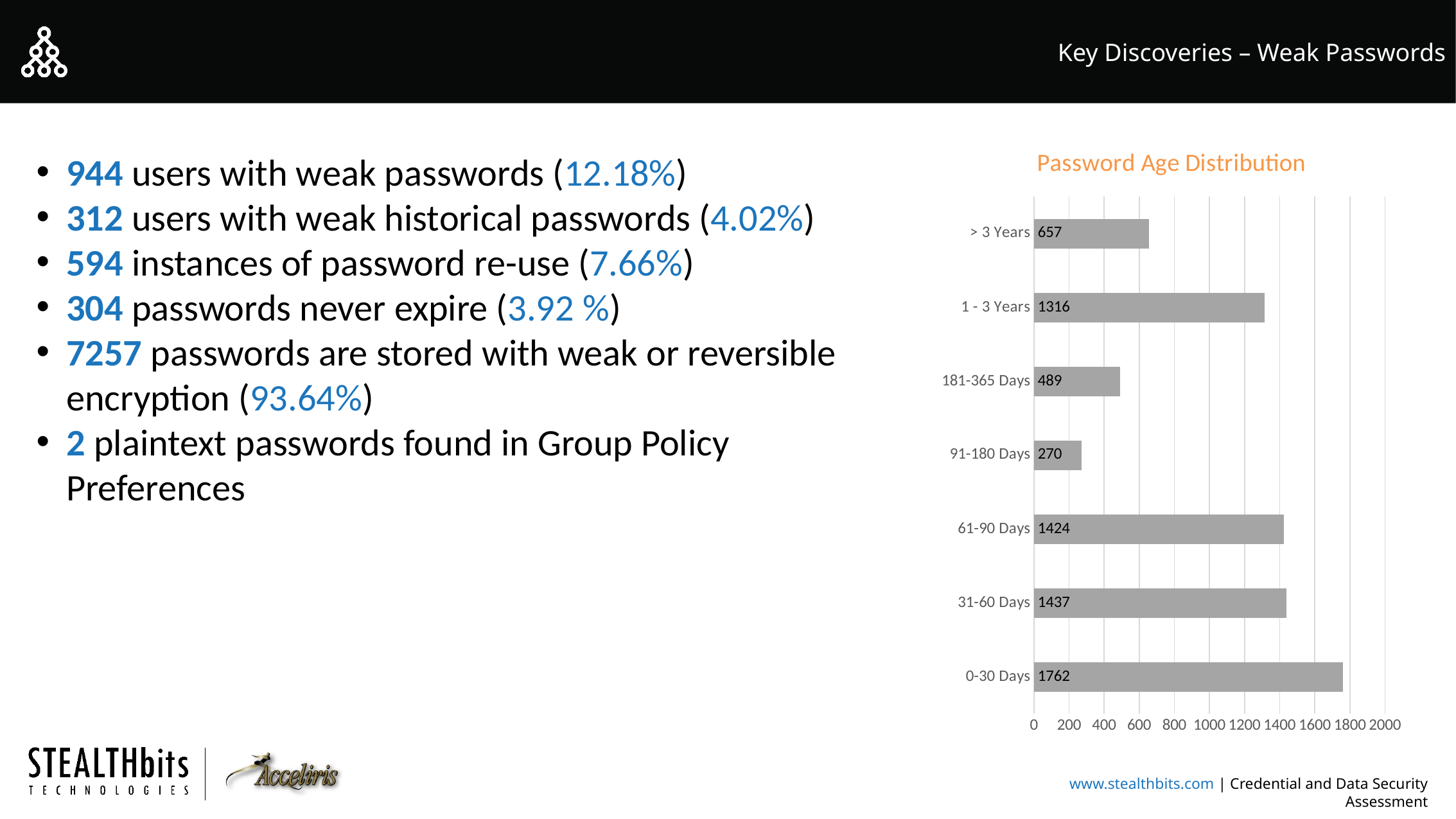
Which category has the lowest value in the Password Age Distribution chart? 91-180 Days What is the value for the > 3 Years category? 657 What is the difference between the values for 0-30 Days and 1 - 3 Years? 446 What is the value for the 91-180 Days category? 270 How many categories are shown in the Password Age Distribution chart? 7 What is the title of the chart on the slide? Password Age Distribution Is the value for 61-90 Days greater or less than 1200? greater Which is larger, the value for 1 - 3 Years or the value for > 3 Years? 1 - 3 Years What is the difference between the values for 181-365 Days and 91-180 Days? 219 What is the value for the 0-30 Days category in the Password Age Distribution chart? 1762 Which category has the highest value in the Password Age Distribution chart? 0-30 Days What kind of chart is the Password Age Distribution chart? bar chart